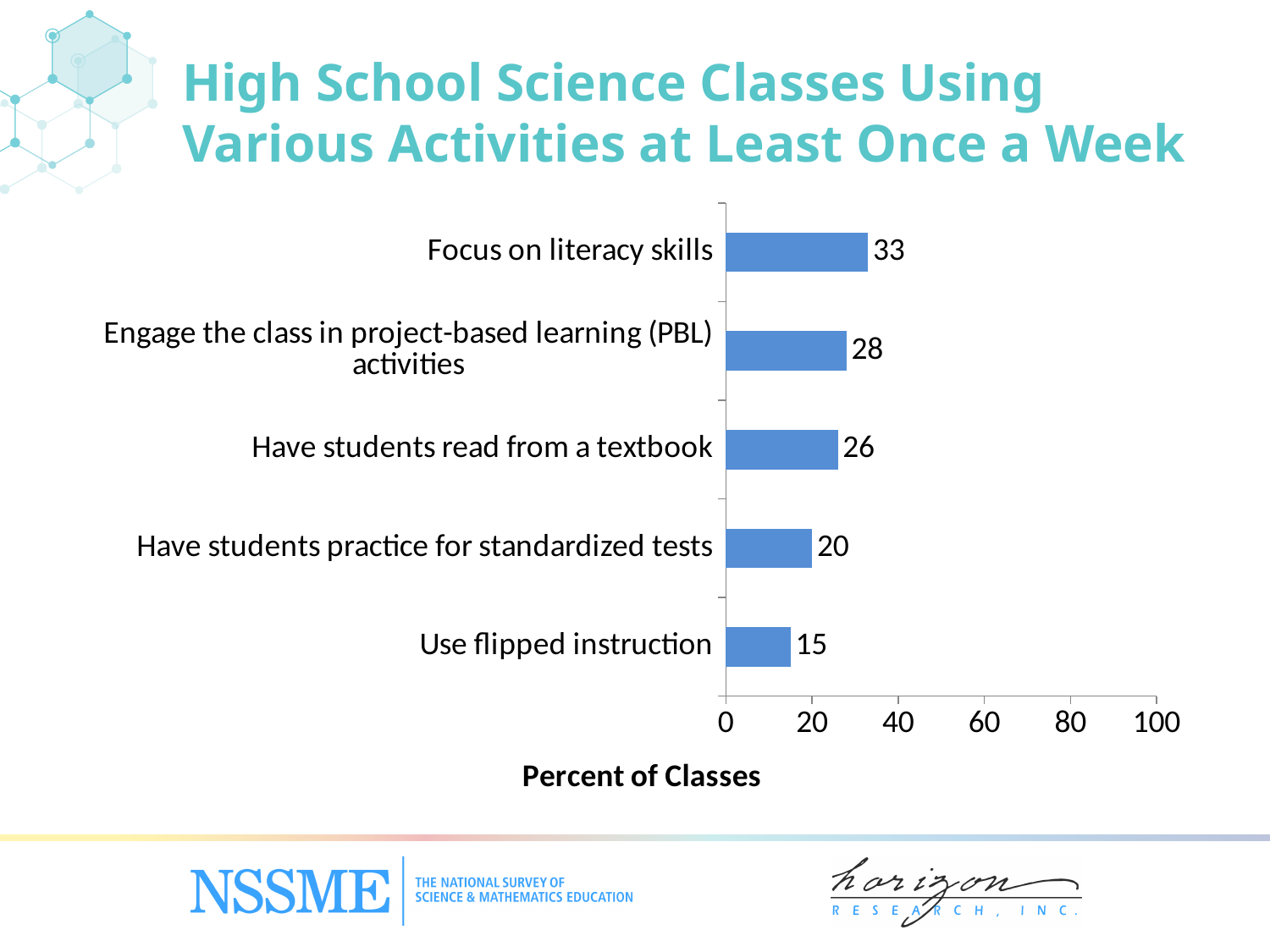
How many activities are shown in the chart? 5 Is the value for 'Engage the class in project-based learning (PBL) activities' greater or less than 40? less Which is larger: the value for 'Have students read from a textbook' or 'Have students practice for standardized tests'? Have students read from a textbook What is the value for 'Use flipped instruction'? 15 What percent of classes focus on literacy skills at least once a week? 33 Which activity has the lowest percent of classes? Use flipped instruction What is the label of the horizontal axis? Percent of Classes Which activity has the highest percent of classes? Focus on literacy skills What percent of classes have students read from a textbook at least once a week? 26 What kind of chart is shown on the slide? Bar chart What is the difference between the values for 'Focus on literacy skills' and 'Use flipped instruction'? 18 What is the difference between 'Engage the class in project-based learning (PBL) activities' and 'Have students practice for standardized tests'? 8